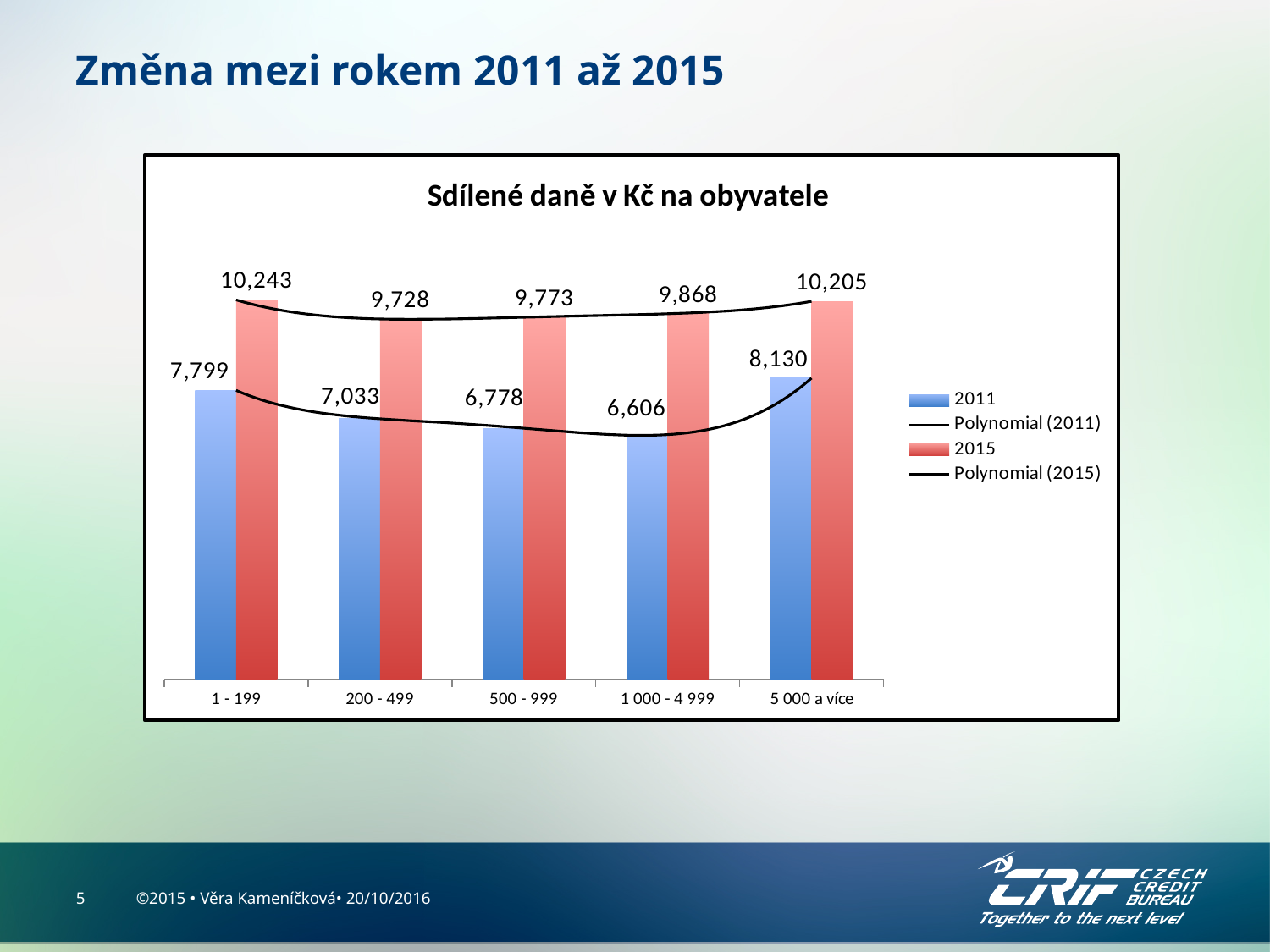
What is the title of the chart? Sdílené daně v Kč na obyvatele How many entries does the legend list? 4 What is the difference between the 2015 and 2011 values for the category 5 000 a více? 2,075 What is the 2015 value for the category 5 000 a více? 10,205 Which category has the highest 2011 value? 5 000 a více What is the 2011 value for the category 1 000 - 4 999? 6,606 What is the 2015 value for the category 1 - 199? 10,243 Which category has the lowest 2015 value? 200 - 499 What kind of chart is shown on the slide? Bar chart Which is larger, the 2011 value for 1 - 199 or the 2011 value for 200 - 499? 1 - 199 How many categories are shown on the x axis? 5 What is the difference between the 2015 and 2011 values for the category 1 - 199? 2,444